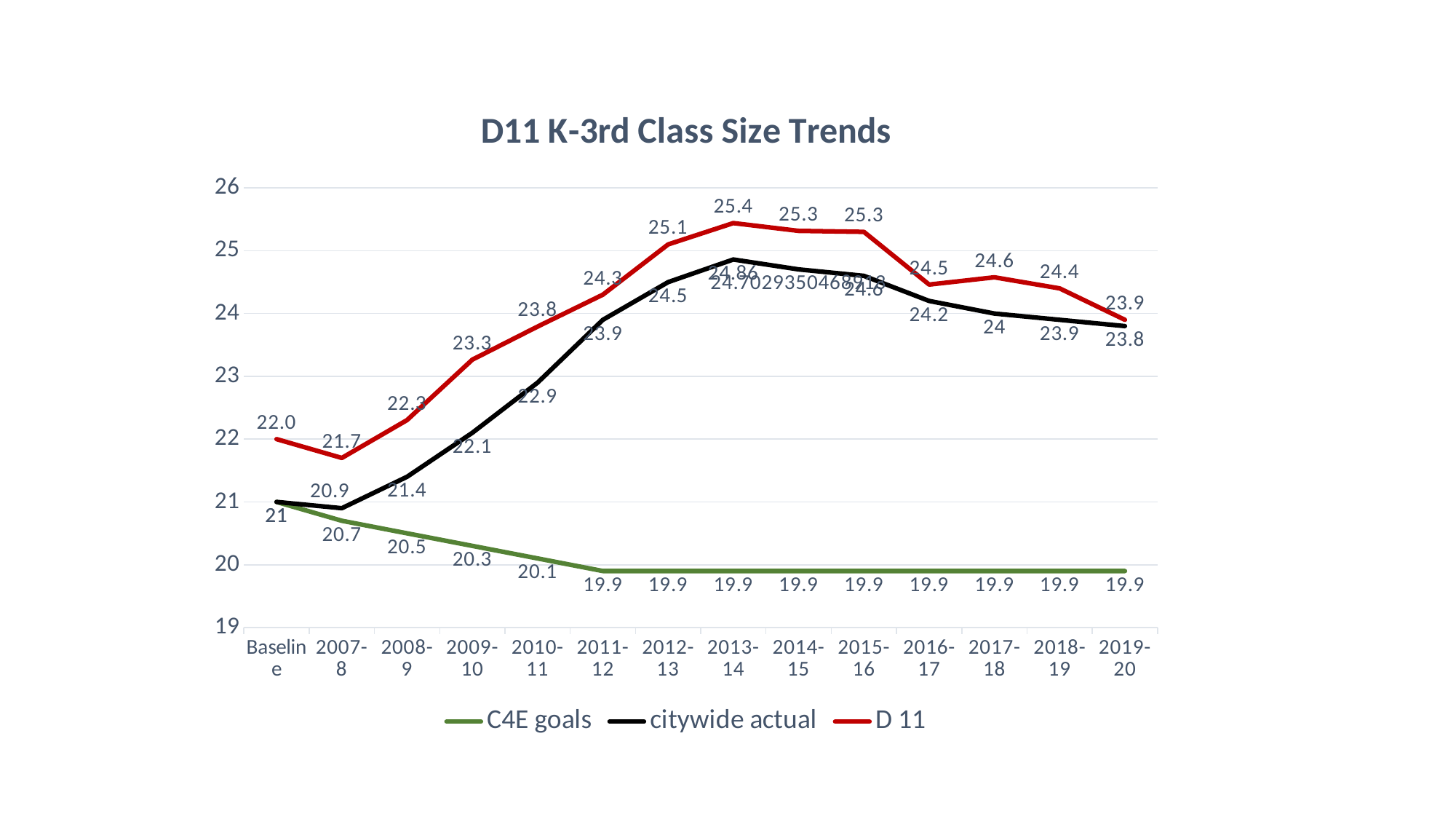
What is the lowest value of the D 11 series? 21.7 What type of chart is shown on the slide? line chart What is the D 11 value for 2013-14? 25.4 What is the citywide actual value for 2011-12? 23.9 What is the C4E goals value for 2009-10? 20.3 Is the D 11 value for 2009-10 greater or less than 23? greater What is the difference between the D 11 value and the citywide actual value in 2019-20? 0.1 How many series does the legend list? 3 Does the C4E goals series rise or fall from Baseline to 2011-12? fall Which is larger in 2012-13, the D 11 value or the citywide actual value? D 11 In which year does the D 11 series reach its highest value? 2013-14 How many categories are shown on the x axis? 14